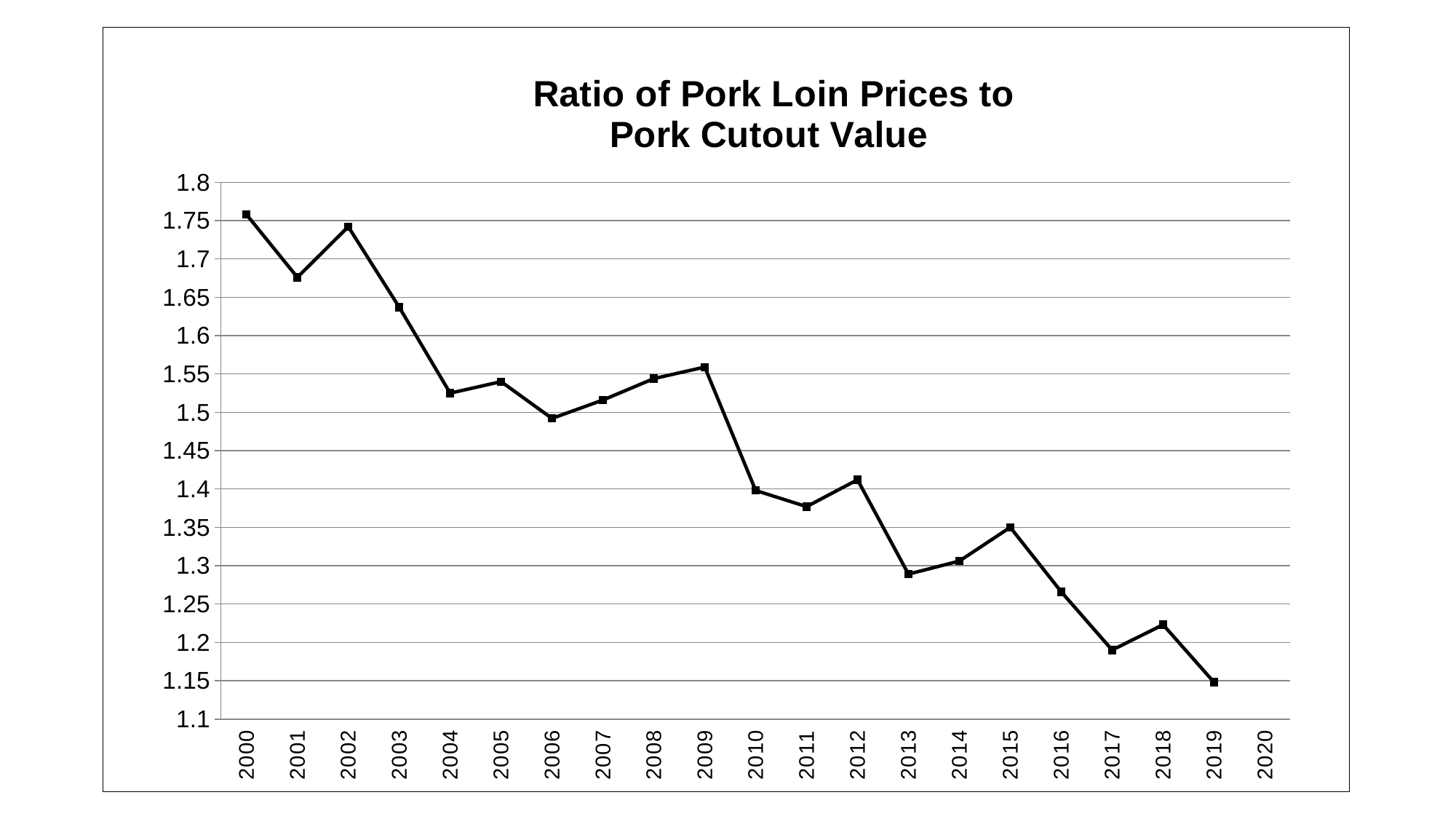
What is the title of the chart? Ratio of Pork Loin Prices to Pork Cutout Value Is the value for 2003 greater or less than 1.6? greater Which year has the highest ratio of pork loin prices to pork cutout value? 2000 How many years have a plotted data point on the line? 20 Is the value for 2019 greater or less than 1.2? less Which year has the larger value, 2015 or 2016? 2015 Is the value for 2010 greater or less than 1.45? less Which year has the lowest ratio of pork loin prices to pork cutout value? 2019 What kind of chart is shown on the slide? line chart Which year has the larger value, 2001 or 2002? 2002 Overall, does the ratio rise or fall from 2000 to 2019? fall